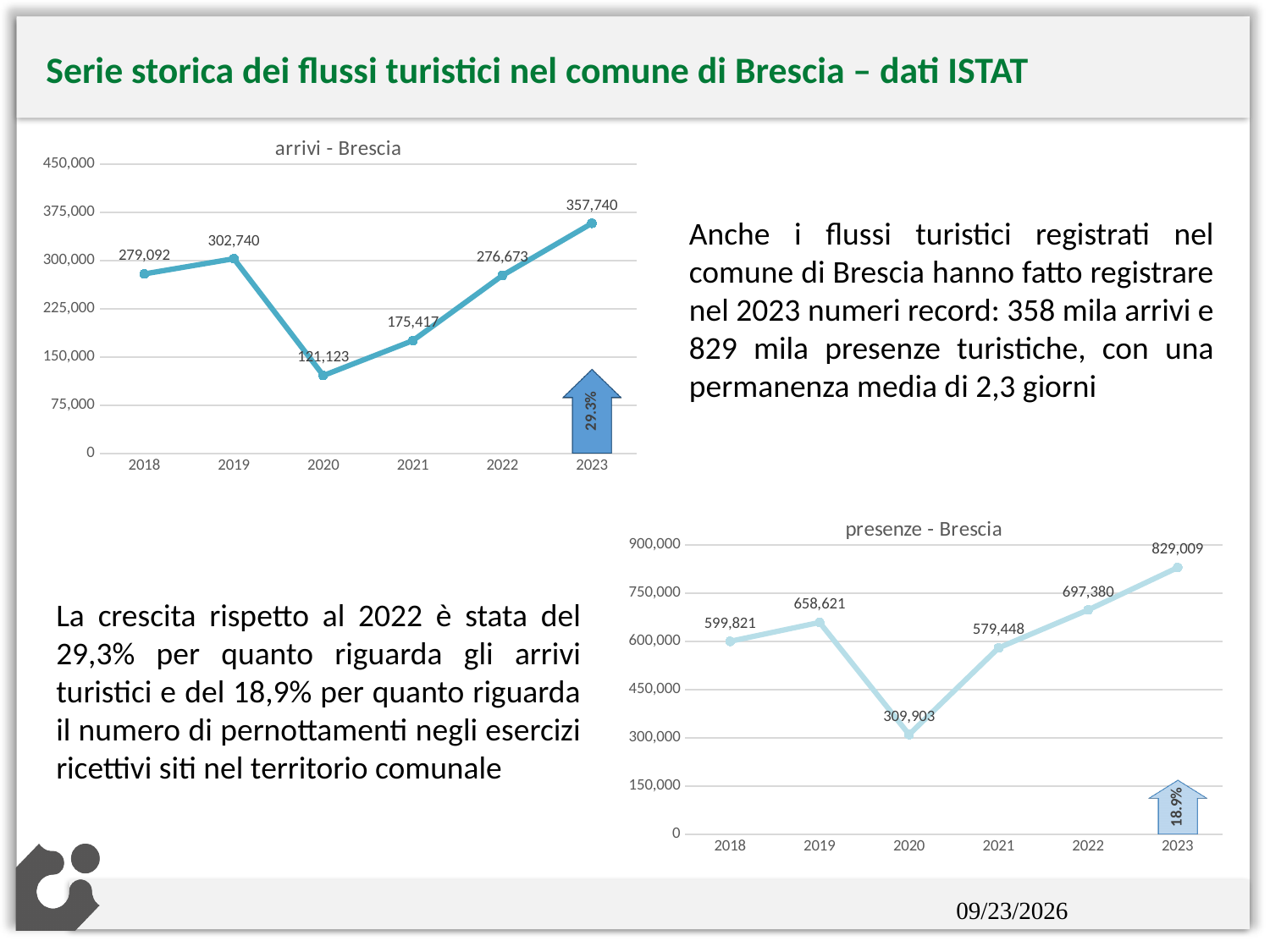
In the 'arrivi - Brescia' chart, what is the value for 2023? 357,740 What percentage is shown in the arrow on the 'arrivi - Brescia' chart? 29.3% In the 'arrivi - Brescia' chart, which is larger, the value for 2019 or the value for 2022? 2019 In the 'presenze - Brescia' chart, do the values rise or fall from 2020 to 2023? rise In the 'presenze - Brescia' chart, what is the value for 2020? 309,903 In the 'presenze - Brescia' chart, which year has the highest value? 2023 In the 'presenze - Brescia' chart, is the value for 2021 greater or less than 600,000? less In the 'presenze - Brescia' chart, what is the difference between the 2023 and 2022 values? 131,629 What kind of chart is the 'arrivi - Brescia' chart? line chart How many years are plotted in the 'presenze - Brescia' chart? 6 In the 'arrivi - Brescia' chart, what is the difference between the 2023 and 2022 values? 81,067 In the 'arrivi - Brescia' chart, which year has the lowest value? 2020